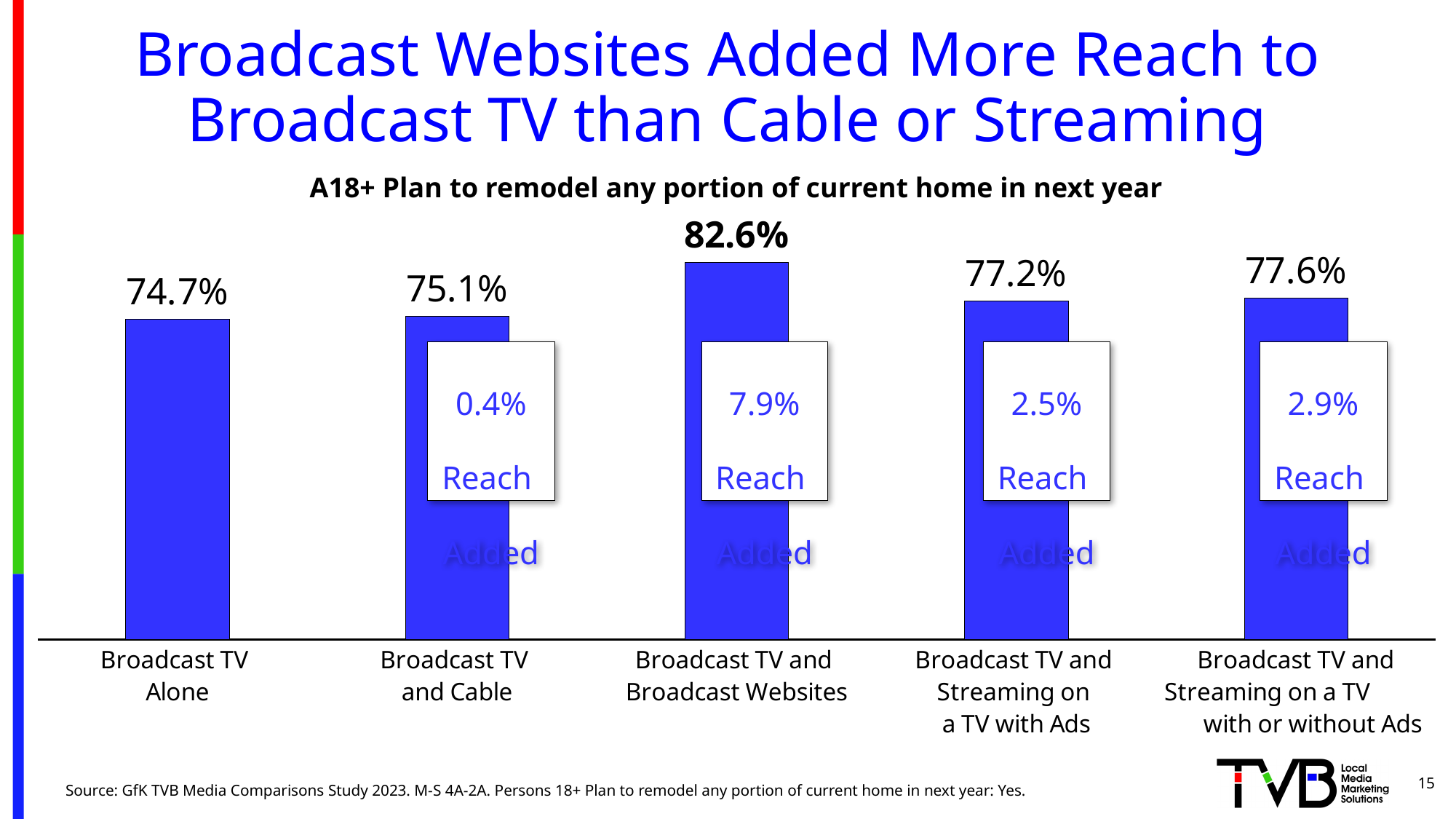
What is the value for Broadcast TV and Cable? 75.1% Which category has the highest value? Broadcast TV and Broadcast Websites What kind of chart is this? bar chart How many categories are shown in the chart? 5 What is the difference between Broadcast TV and Broadcast Websites and Broadcast TV Alone? 7.9% Which category has the lowest value? Broadcast TV Alone What is the value for Broadcast TV Alone? 74.7% How much reach is added by Broadcast TV and Streaming on a TV with or without Ads compared with Broadcast TV Alone? 2.9% What is the value for Broadcast TV and Streaming on a TV with Ads? 77.2% Which is larger: Broadcast TV and Streaming on a TV with or without Ads, or Broadcast TV and Cable? Broadcast TV and Streaming on a TV with or without Ads What is the subtitle of the chart? A18+ Plan to remodel any portion of current home in next year What is the value for Broadcast TV and Broadcast Websites? 82.6%